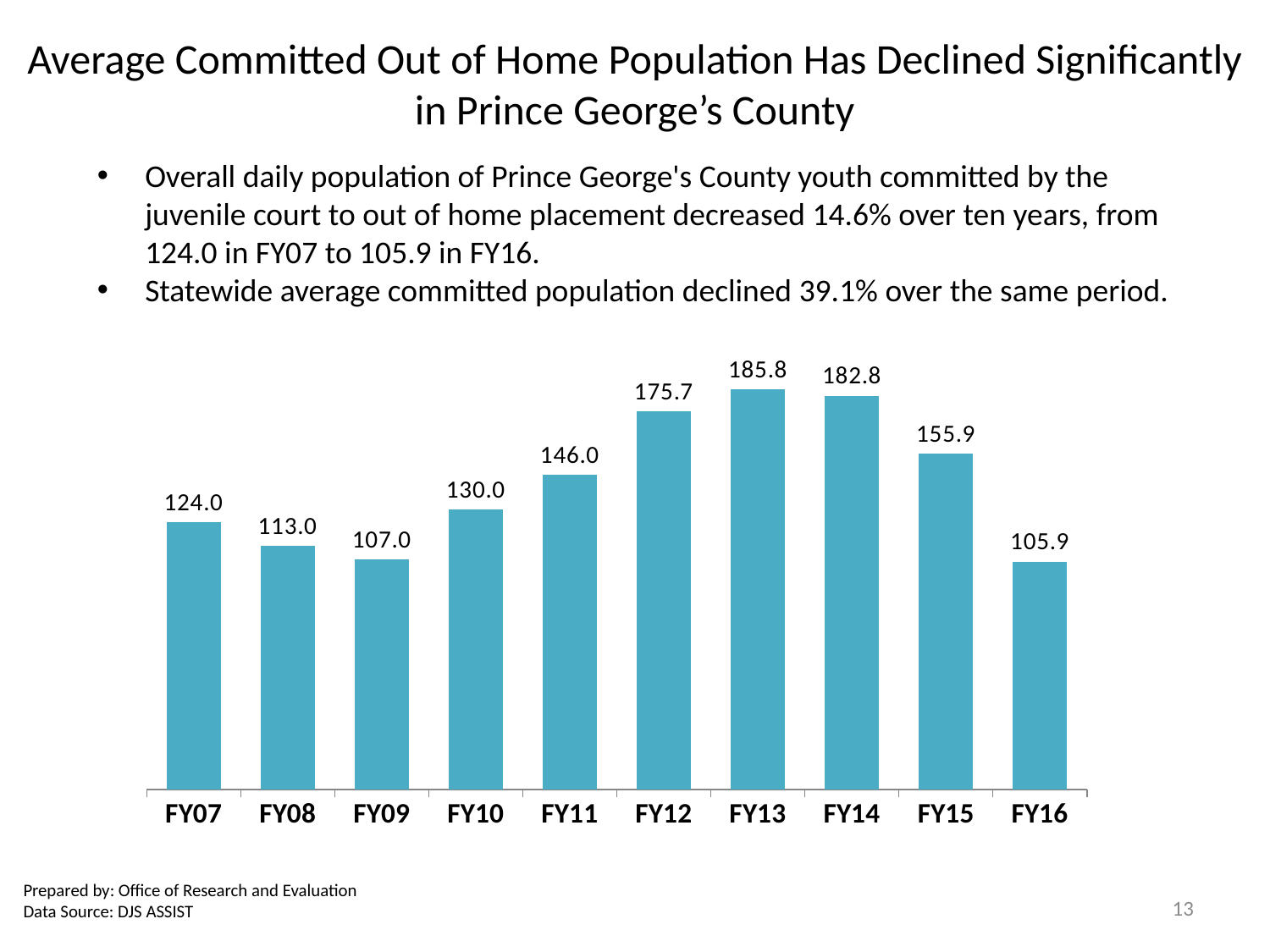
Which fiscal year has the lowest value? FY16 What is the difference between the values for FY07 and FY16? 18.1 What is the value for FY07? 124.0 How many fiscal years are shown on the x axis? 10 Which fiscal year has the highest value? FY13 Which is larger, the value for FY12 or the value for FY15? FY12 What kind of chart is shown on the slide? bar chart What colour are the bars in the chart? blue What is the value for FY16? 105.9 What is the value for FY13? 185.8 What is the difference between the values for FY13 and FY14? 3.0 Do the values rise or fall from FY13 to FY16? fall